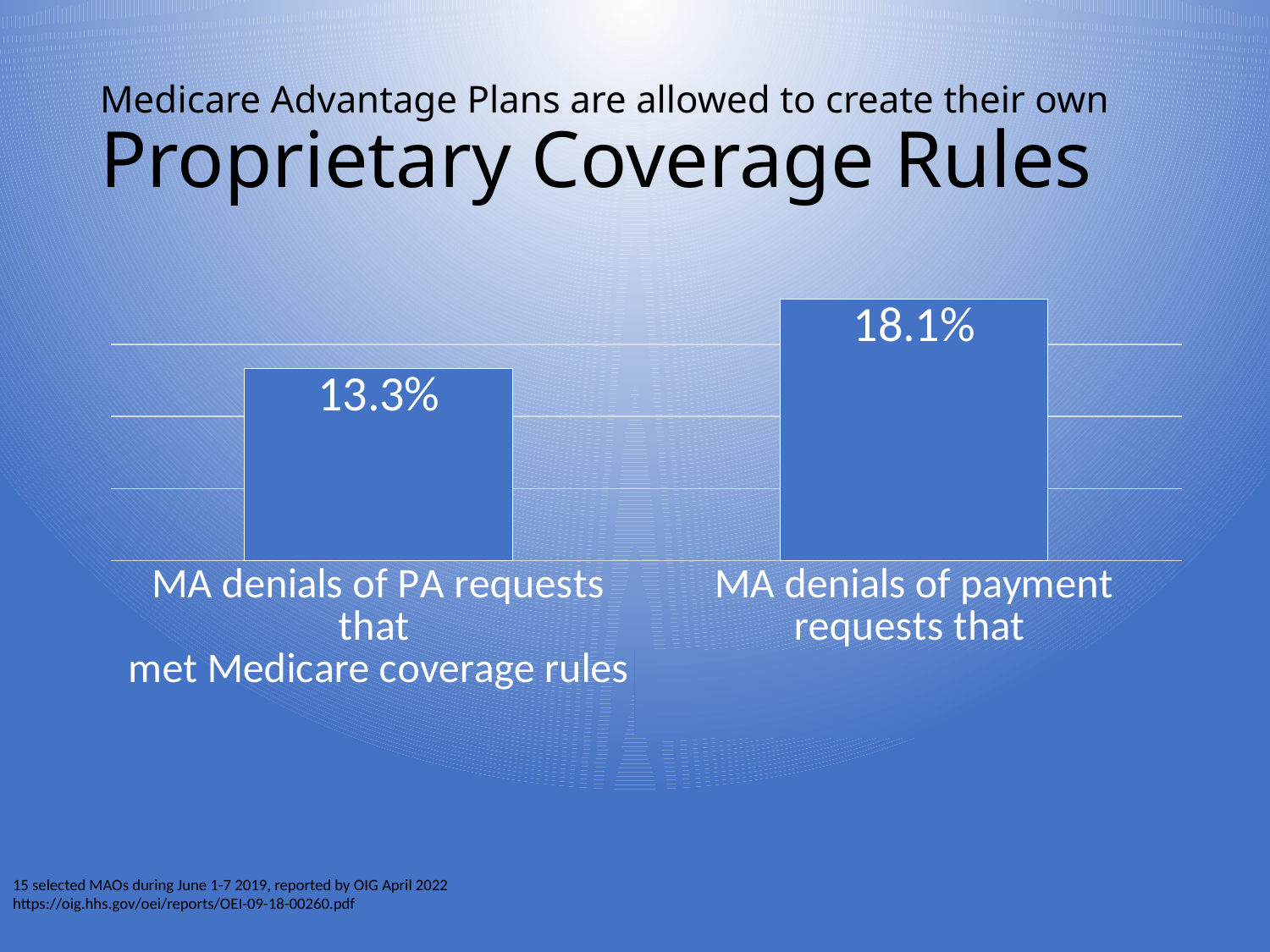
What is the main title of the slide containing the chart? Proprietary Coverage Rules What is the value for MA denials of payment requests that met Medicare coverage rules? 18.1% Do the values rise or fall from the left bar to the right bar? rise What is the difference between the value for MA denials of payment requests and the value for MA denials of PA requests? 4.8% What colour are the bars in the chart? blue What kind of chart is shown on the slide? bar chart Is the value for MA denials of PA requests larger or smaller than the value for MA denials of payment requests? smaller What is the value for MA denials of PA requests that met Medicare coverage rules? 13.3% How many categories are shown in the chart? 2 Which category has the higher value? MA denials of payment requests that met Medicare coverage rules Which category has the lower value? MA denials of PA requests that met Medicare coverage rules